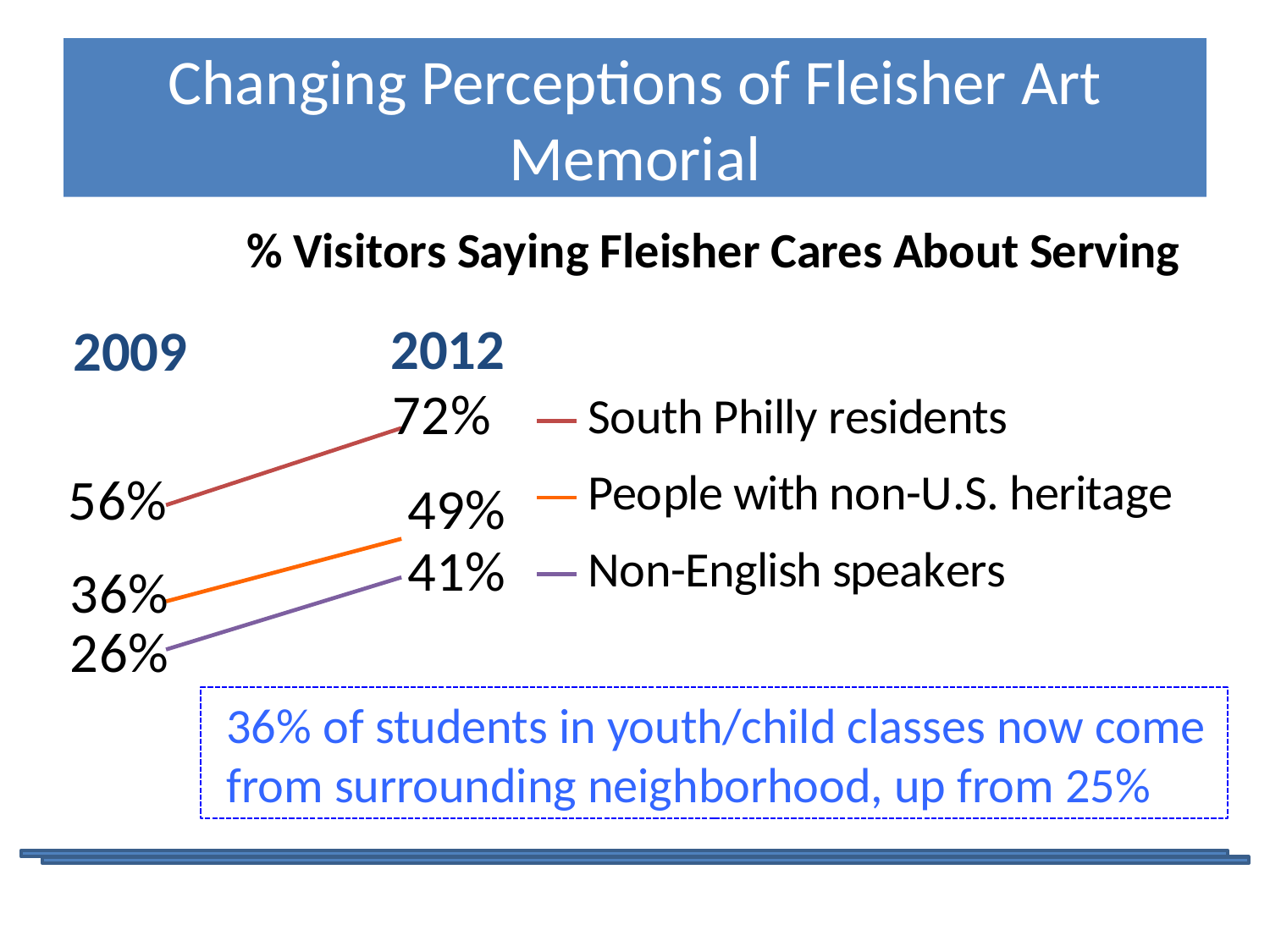
Which series had the highest value in 2012? South Philly residents What was the value for South Philly residents in 2009? 56% By how many percentage points did the value for Non-English speakers change from 2009 to 2012? 15 Which series had the lowest value in 2009? Non-English speakers Do the values for People with non-U.S. heritage rise or fall from 2009 to 2012? rise What was the value for People with non-U.S. heritage in 2012? 49% What is the chart's title? % Visitors Saying Fleisher Cares About Serving What kind of chart is shown on the slide? line chart What was the value for Non-English speakers in 2009? 26% How many series does the legend list? 3 How many years are plotted along the x axis? 2 What was the value for South Philly residents in 2012? 72%